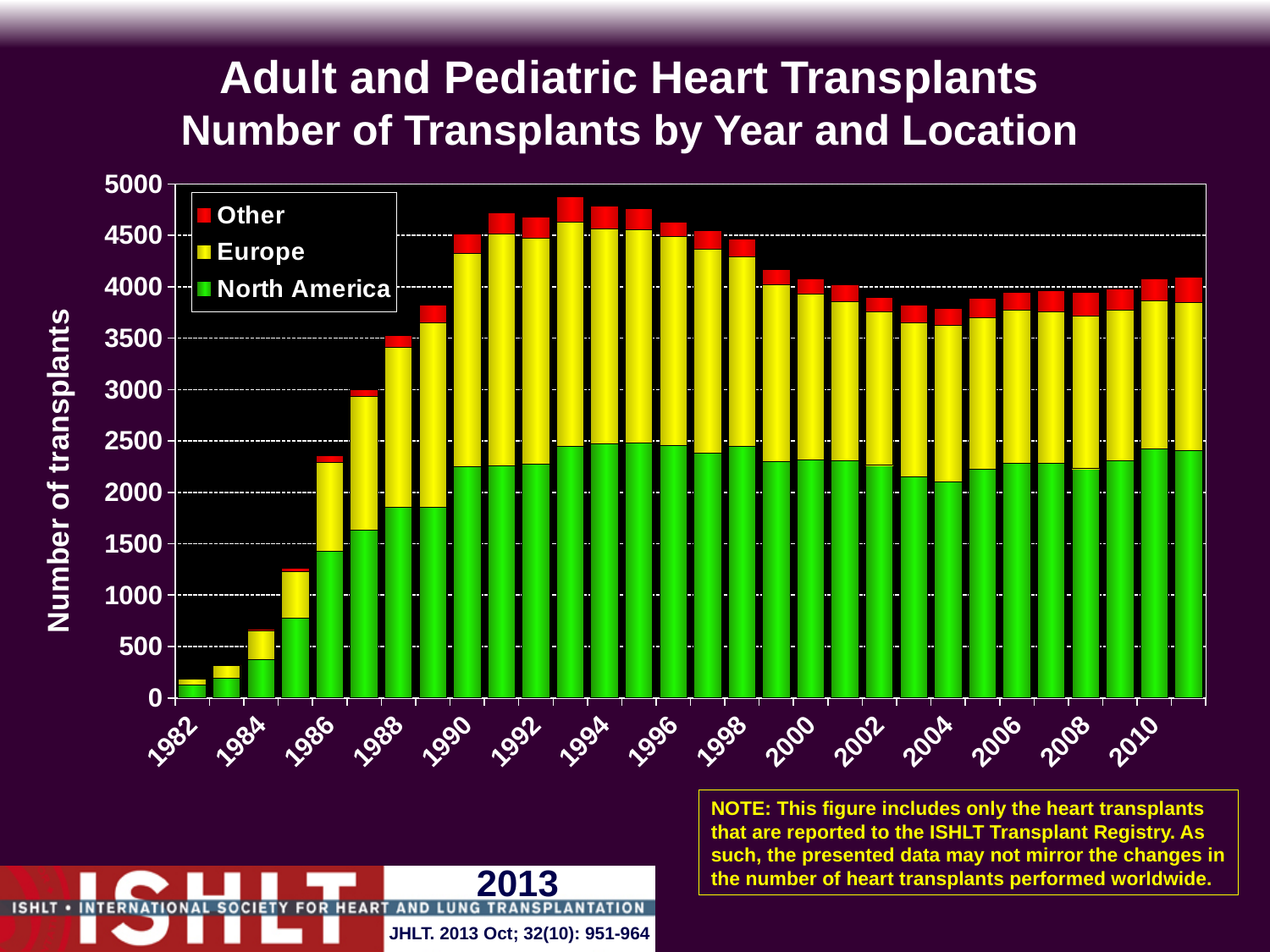
Is the total number of transplants in 1982 greater or less than 500? less How many series does the legend list? 3 Which series is shown in green? North America Which series is shown in red? Other Which year has the highest total number of transplants? 1993 How many years (bars) are plotted on the chart? 30 Which year has the larger total number of transplants, 1990 or 2000? 1990 Do total transplants rise or fall from 1982 to 1994? rise What kind of chart is shown on the slide? stacked bar chart Which year has the lowest total number of transplants? 1982 Is the total number of transplants in 1994 greater or less than 4500? greater Is the total number of transplants in 2004 greater or less than 4000? less